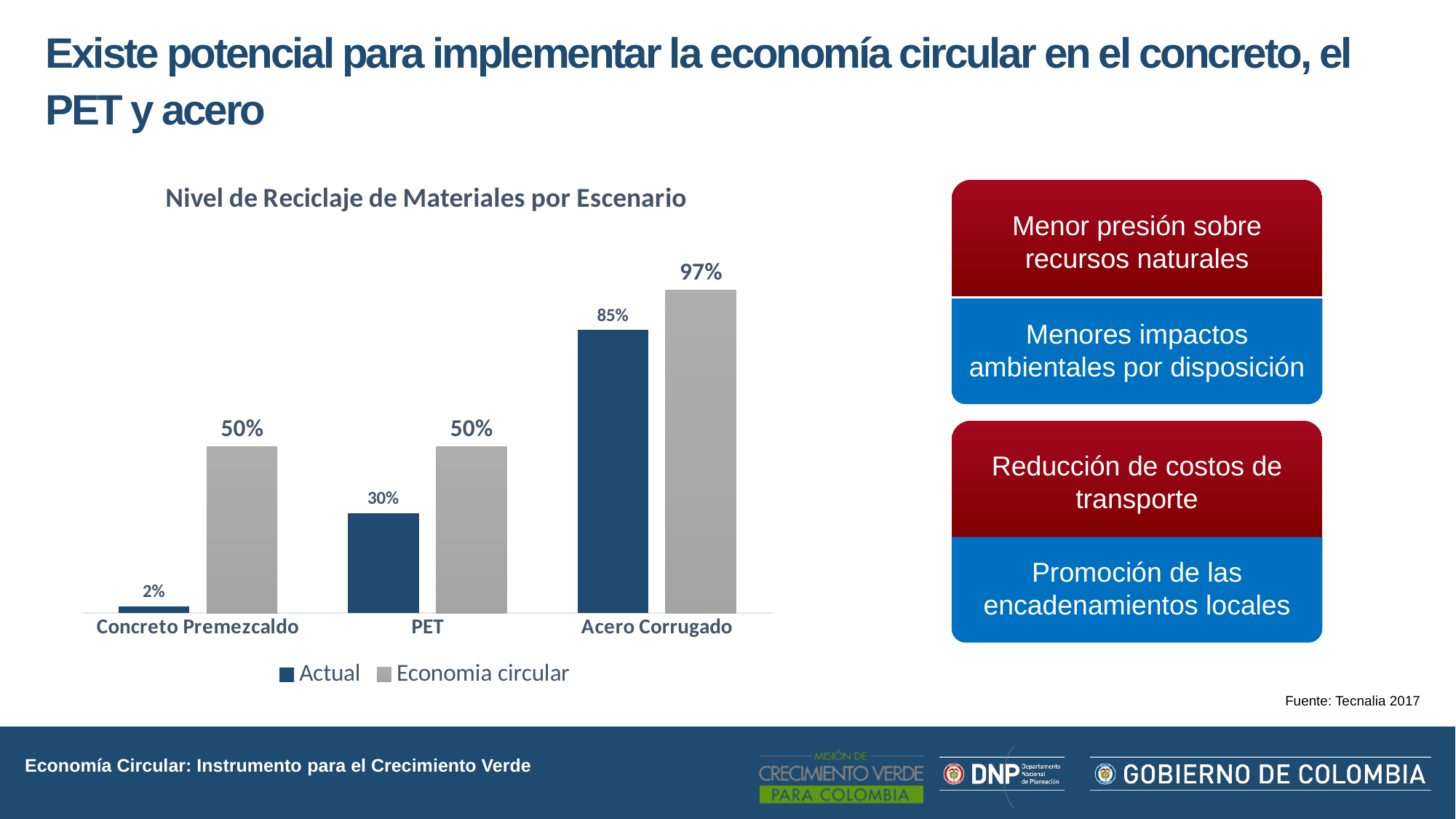
What is the Actual value for PET? 30% What kind of chart is shown? Bar chart How many categories are shown on the x axis? 3 What is the Actual recycling level for Concreto Premezcaldo? 2% Which category has the highest Actual value? Acero Corrugado Which is larger: the Actual value for Acero Corrugado or the Economia circular value for PET? Actual value for Acero Corrugado How many series does the legend list? 2 What is the Economia circular value for Acero Corrugado? 97% What is the difference between the Economia circular and Actual values for Concreto Premezcaldo? 48% What is the difference between the Economia circular and Actual values for PET? 20% What is the title of the chart? Nivel de Reciclaje de Materiales por Escenario Which category has the lowest Economia circular value? Concreto Premezcaldo and PET (both 50%)